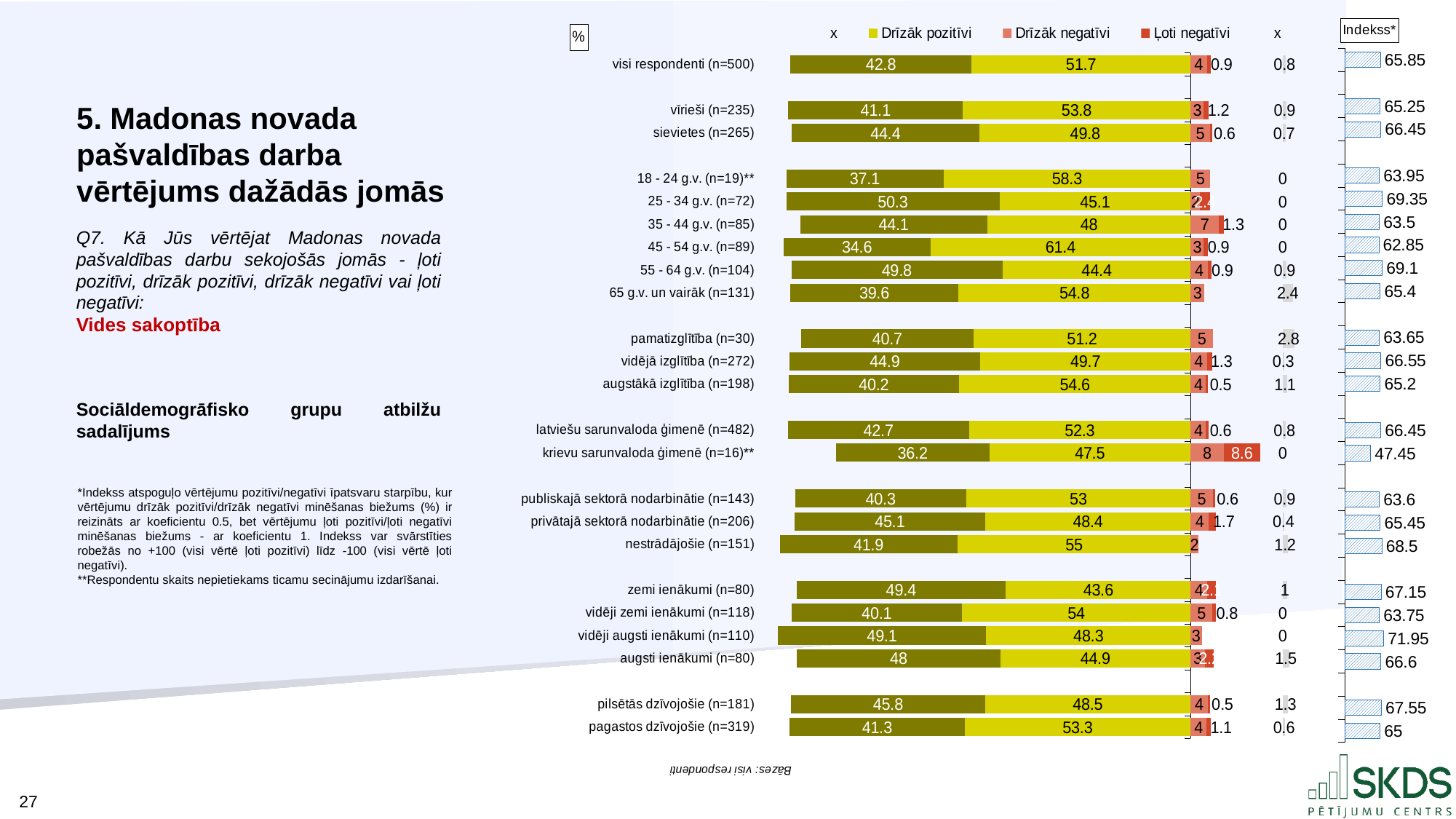
What is the difference between the Indekss* values for pilsētās dzīvojošie (n=181) and pagastos dzīvojošie (n=319)? 2.55 How many respondent groups are shown in the chart? 23 What is the "Drīzāk pozitīvi" value for visi respondenti (n=500)? 51.7 What is the Indekss* value for vidēji augsti ienākumi (n=110)? 71.95 Which group has the lowest Indekss* value? krievu sarunvaloda ģimenē (n=16)** What is the value of the first (dark olive) segment for sievietes (n=265)? 44.4 Which has the larger first (dark olive) segment: 25 - 34 g.v. (n=72) or 18 - 24 g.v. (n=19)**? 25 - 34 g.v. (n=72) What is the difference between the "Drīzāk pozitīvi" values for vīrieši (n=235) and sievietes (n=265)? 4 What is the "Ļoti negatīvi" value for krievu sarunvaloda ģimenē (n=16)**? 8.6 Which group has the highest "Drīzāk pozitīvi" value? 45 - 54 g.v. (n=89) What kind of chart is used to show the response distribution? Stacked horizontal bar chart Which group has the highest Indekss* value? vidēji augsti ienākumi (n=110)